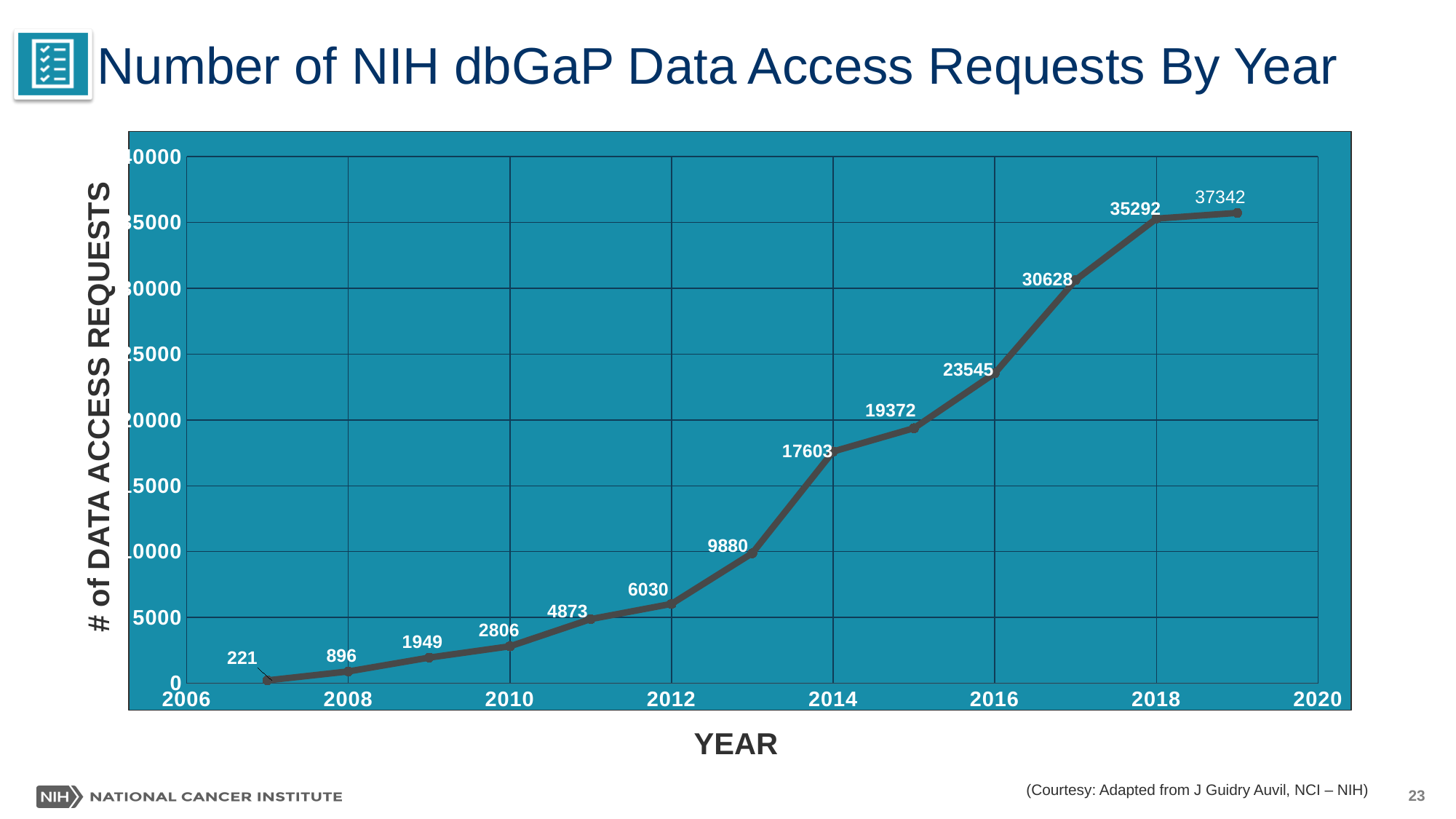
What is the difference in data access requests between 2018 and 2017? 4664 Which year has the lowest number of data access requests? 2007 What is the difference in data access requests between 2014 and 2013? 7723 Which year had more data access requests, 2012 or 2013? 2013 What type of chart is shown on the slide? line chart What is the value plotted for 2011? 4873 How many data access requests were there in 2014? 17603 Do the values rise or fall from 2007 to 2019? rise How many data points are plotted on the line? 13 What is the number of data access requests for 2019? 37342 Is the value for 2016 greater or less than 20000? greater Which year has the highest number of data access requests? 2019